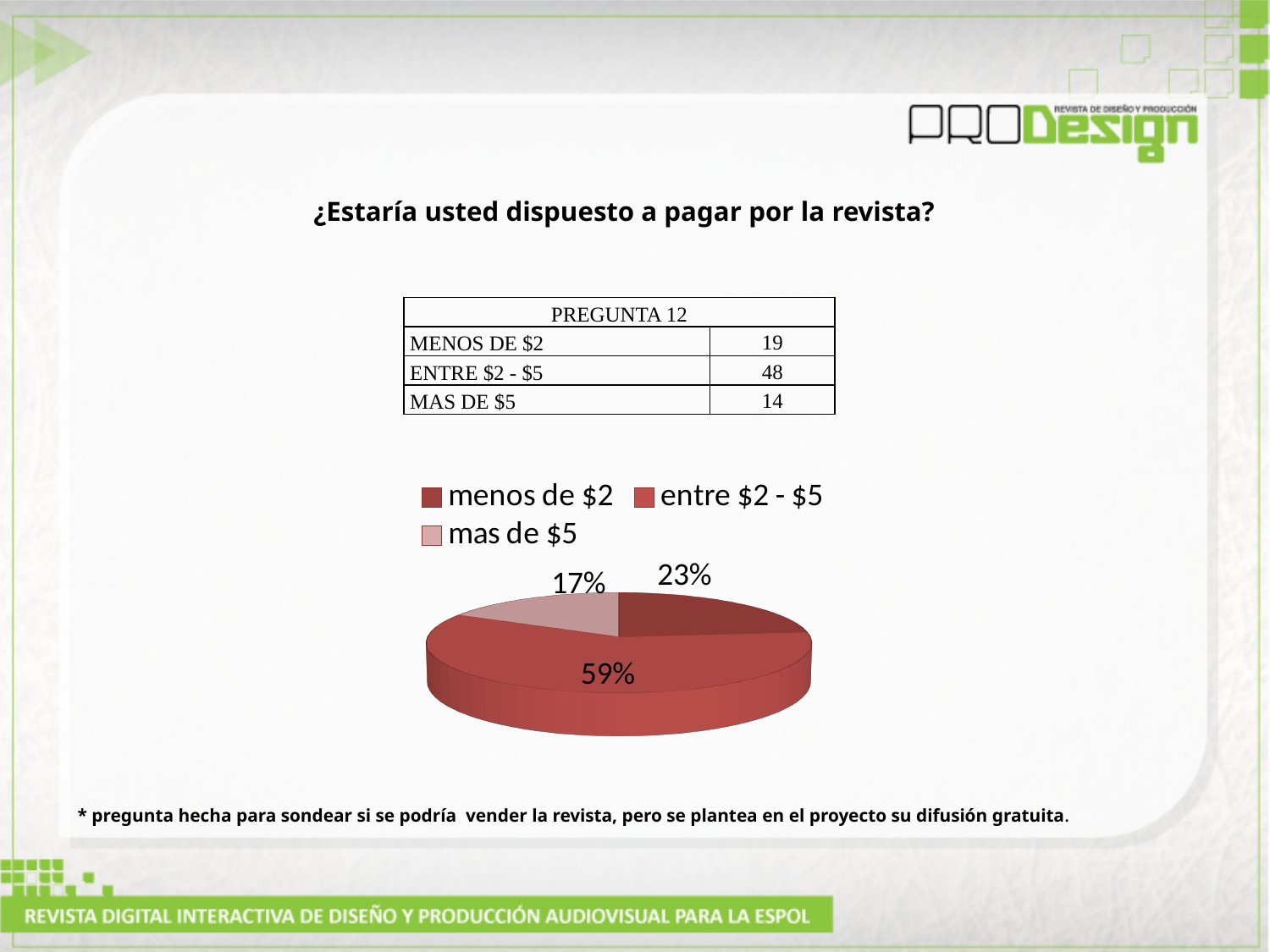
What is the difference in percentage points between the "entre $2 - $5" slice and the "menos de $2" slice? 36 What is the difference in percentage points between the "menos de $2" slice and the "mas de $5" slice? 6 What type of chart is shown on the slide? pie chart How many slices does the pie chart have? 3 Which category has the smallest slice in the pie chart? mas de $5 What percentage of the pie chart corresponds to "menos de $2"? 23% Which legend entry is shown with the lightest pink colour in the pie chart? mas de $5 Which category has the largest slice in the pie chart? entre $2 - $5 What percentage of the pie chart corresponds to "mas de $5"? 17% How many entries does the legend of the pie chart list? 3 What percentage of the pie chart corresponds to "entre $2 - $5"? 59% Which slice is larger in the pie chart: "menos de $2" or "mas de $5"? menos de $2